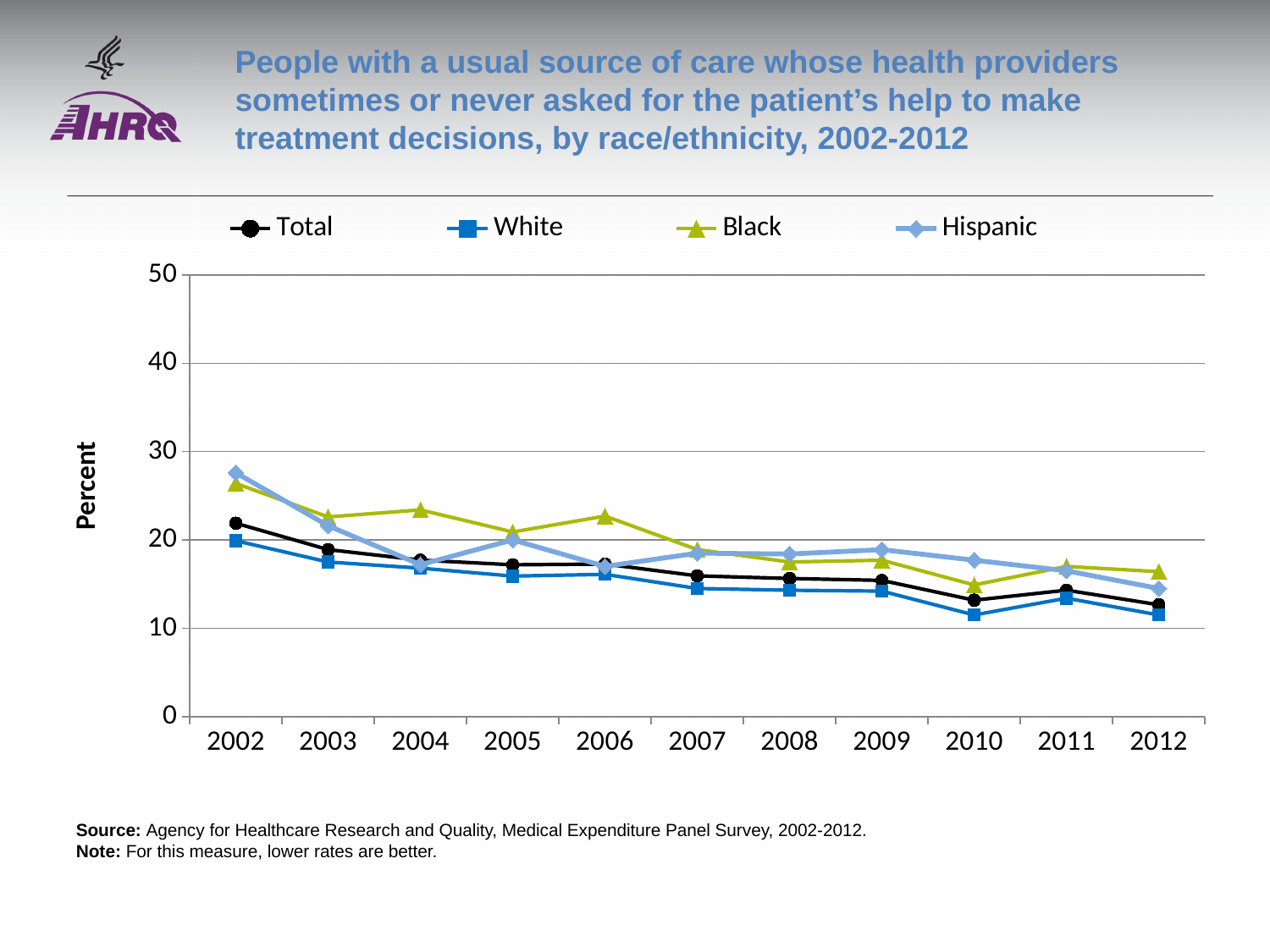
Is the value for White in 2012 greater or less than 20? less Which series has the lowest value in 2012? White Is the value for Black in 2004 greater or less than 20? greater Does the Total series generally rise or fall from 2002 to 2012? fall In 2012, which is larger, the value for Black or the value for White? Black Does the White series generally rise or fall from 2002 to 2012? fall How many series does the legend list? 4 What kind of chart is shown on the slide? line chart Is the value for Hispanic in 2002 greater or less than 20? greater In which year does the Hispanic series reach its highest value? 2002 How many years are plotted along the x axis? 11